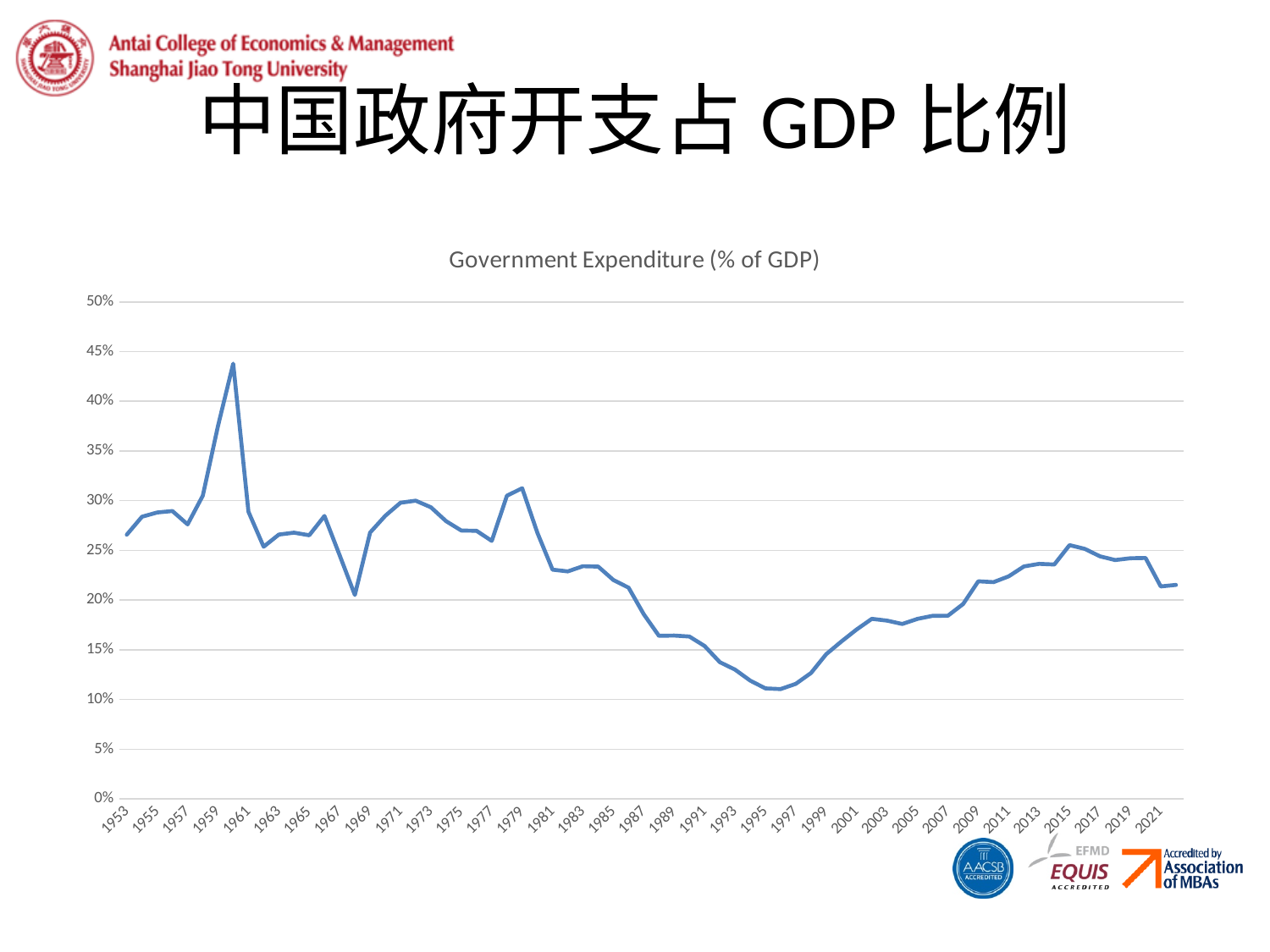
Does the line generally rise or fall between 1979 and 1995? fall Is the value for 1960 greater or less than 40%? greater Is the value for 1995 greater or less than 15%? less Is the value for 1979 greater or less than 30%? greater What is the title of the chart? Government Expenditure (% of GDP) Does the line generally rise or fall between 1997 and 2015? rise What is the highest value shown on the vertical axis? 50% Which year has the larger value, 1953 or 2021? 1953 In which year does government expenditure as a share of GDP reach its highest point? 1960 What kind of chart is shown on the slide? line chart